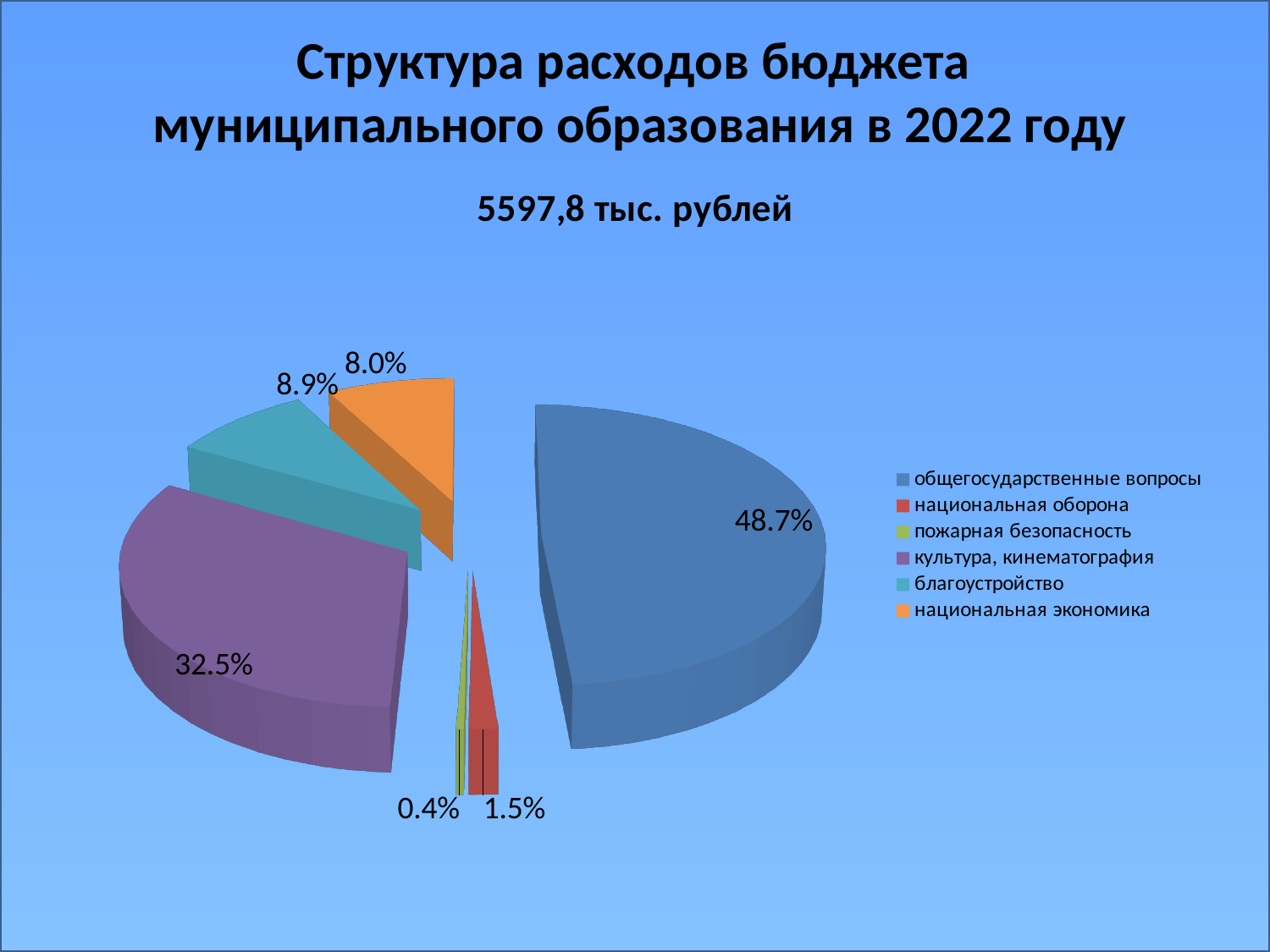
What share of the pie does пожарная безопасность take? 0.4% What share of the pie does культура, кинематография take? 32.5% What is the difference between the shares of общегосударственные вопросы and культура, кинематография? 16.2% What kind of chart is shown on the slide? pie chart What share of the pie does национальная оборона take? 1.5% How many slices does the pie chart have? 6 Which category has the largest share of the pie? общегосударственные вопросы Which category has the smallest share of the pie? пожарная безопасность Which is larger, the share of благоустройство or the share of национальная экономика? благоустройство